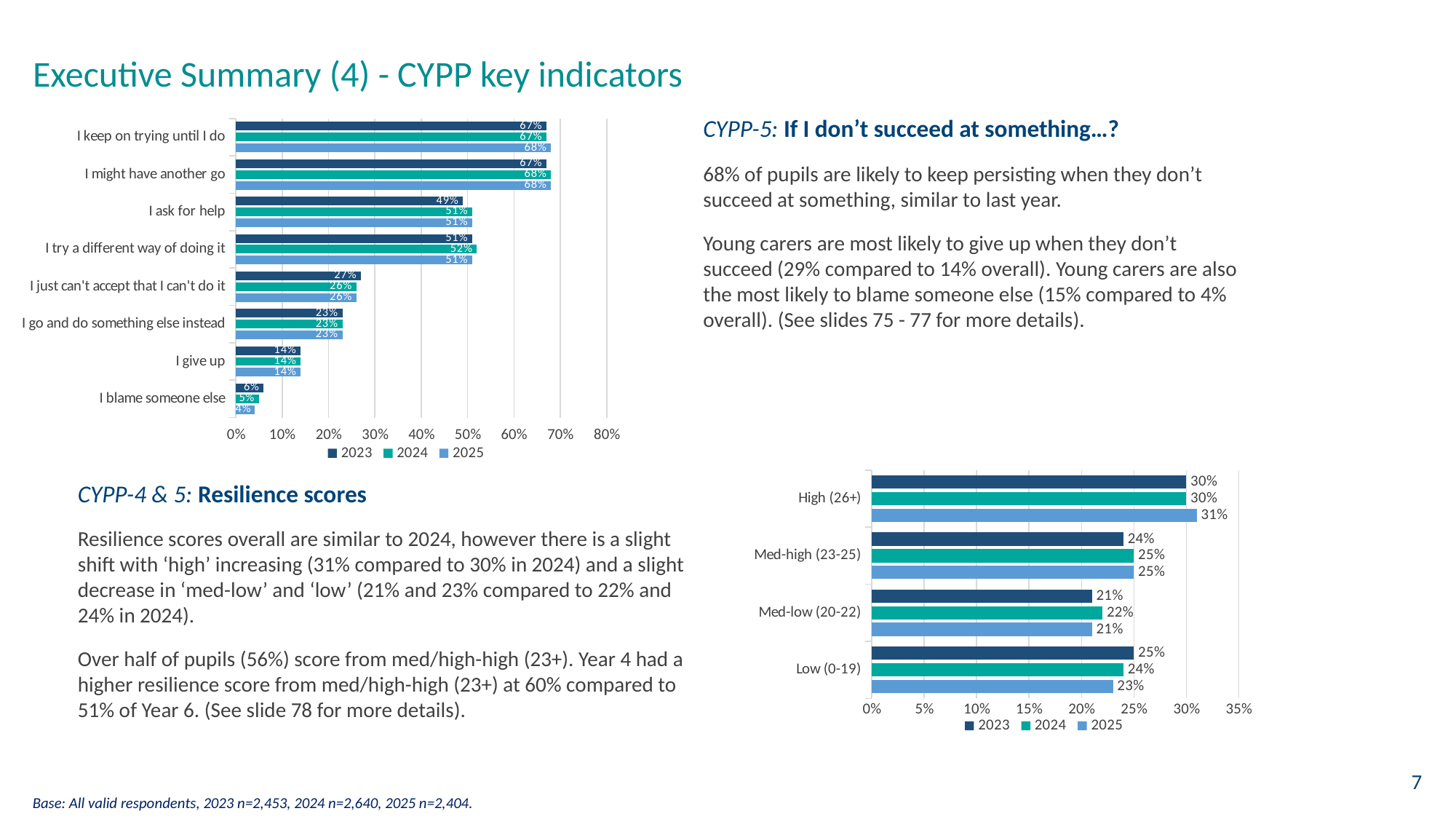
In the bottom-right chart, what is the 2025 value for 'High (26+)'? 31% In the top-left chart, what is the 2023 value for 'I ask for help'? 49% What kind of chart is the top-left chart? Bar chart In the top-left chart, how many categories are shown on the y axis? 8 In the top-left chart, which category has the lowest values across all years? I blame someone else In the bottom-right chart, what is the difference between the 2023 and 2025 values for 'Low (0-19)'? 2% In the bottom-right chart, which is larger for 2025: 'Med-high (23-25)' or 'Med-low (20-22)'? Med-high (23-25) In the top-left chart, what is the difference between the 2023 and 2025 values for 'I blame someone else'? 2% In the top-left chart, how many series does the legend list? 3 In the top-left chart, what is the 2025 value for 'I keep on trying until I do'? 68% In the bottom-right chart, which category has the highest value in 2025? High (26+) In the bottom-right chart, what is the 2023 value for 'Low (0-19)'? 25%